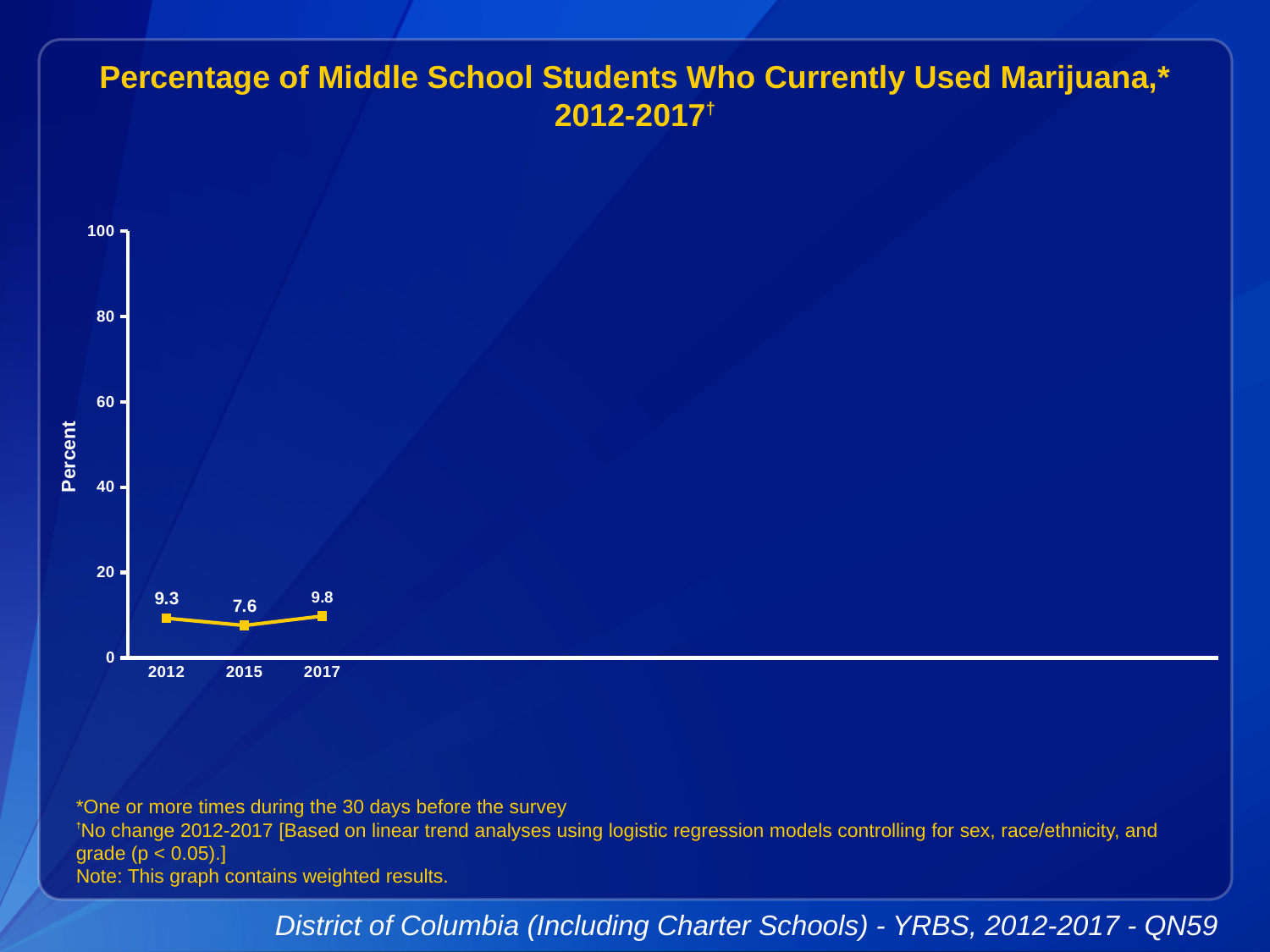
Is the value for 2017 greater or less than 20? less How many years are plotted on the chart? 3 Which is larger, the value for 2012 or the value for 2015? 2012 What is the value plotted for 2015? 7.6 Which year has the lowest percentage? 2015 What is the difference between the 2012 and 2015 values? 1.7 Which year has the highest percentage? 2017 What is the difference between the 2017 and 2015 values? 2.2 What kind of chart is shown on the slide? line chart What is the value plotted for 2017? 9.8 What percentage of middle school students currently used marijuana in 2012? 9.3 What is the label on the y axis? Percent